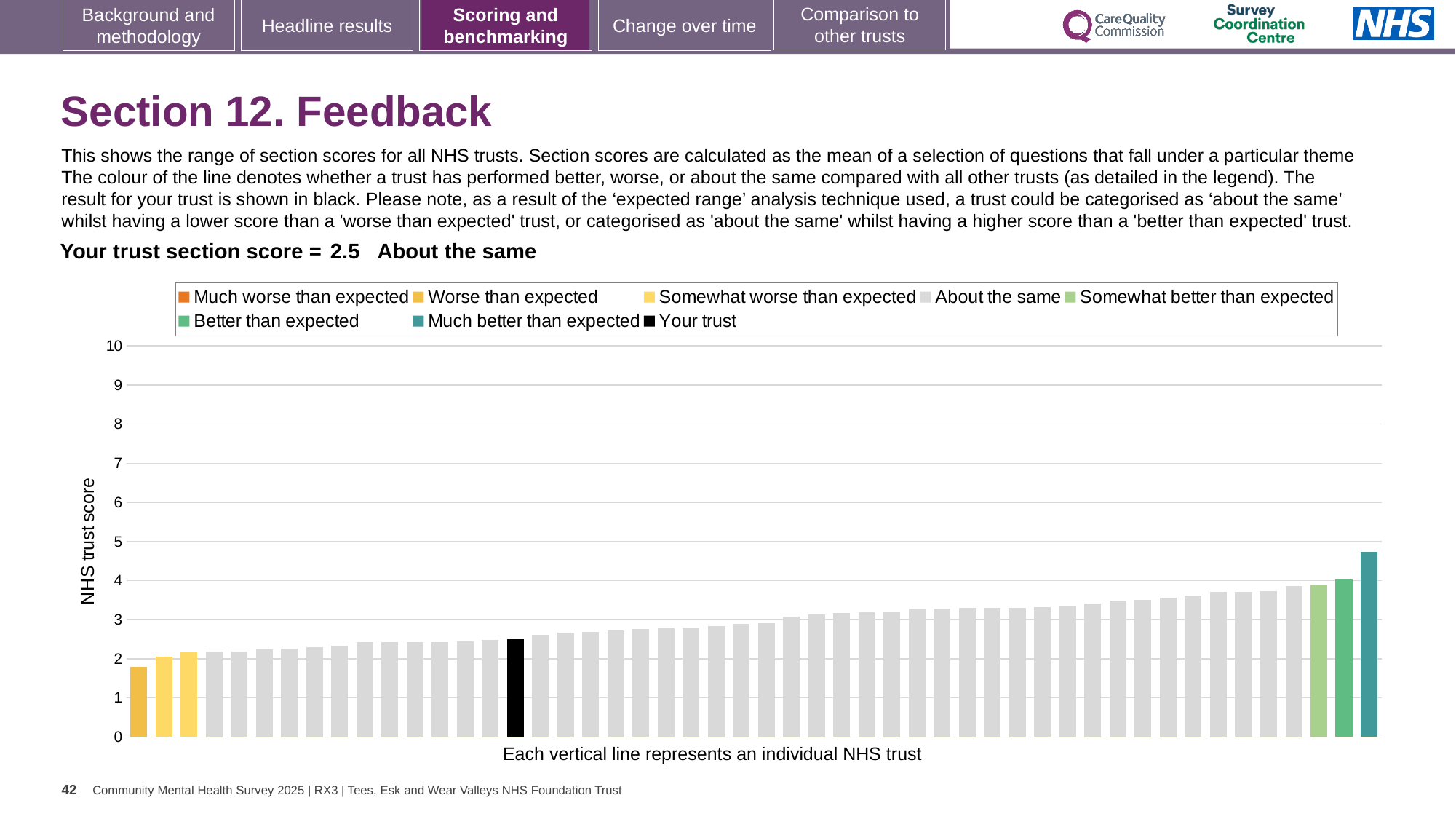
What is the label on the vertical axis of the chart? NHS trust score Which performance category is your trust placed in for Section 12? About the same How many entries does the chart legend list? 8 Do the bar values rise or fall from left to right along the x axis? rise Is the value of the black bar (your trust) greater or less than 3? less What is the section score for your trust shown on the slide? 2.5 Which legend category does the tallest bar belong to? Much better than expected Is the value of the shortest bar greater or less than 2? less What kind of chart is shown on the slide? bar chart Which is larger: the value of your trust's bar or the value of the tallest bar? the tallest bar What colour is the bar representing your trust? black Is the value of the tallest bar greater or less than 4? greater